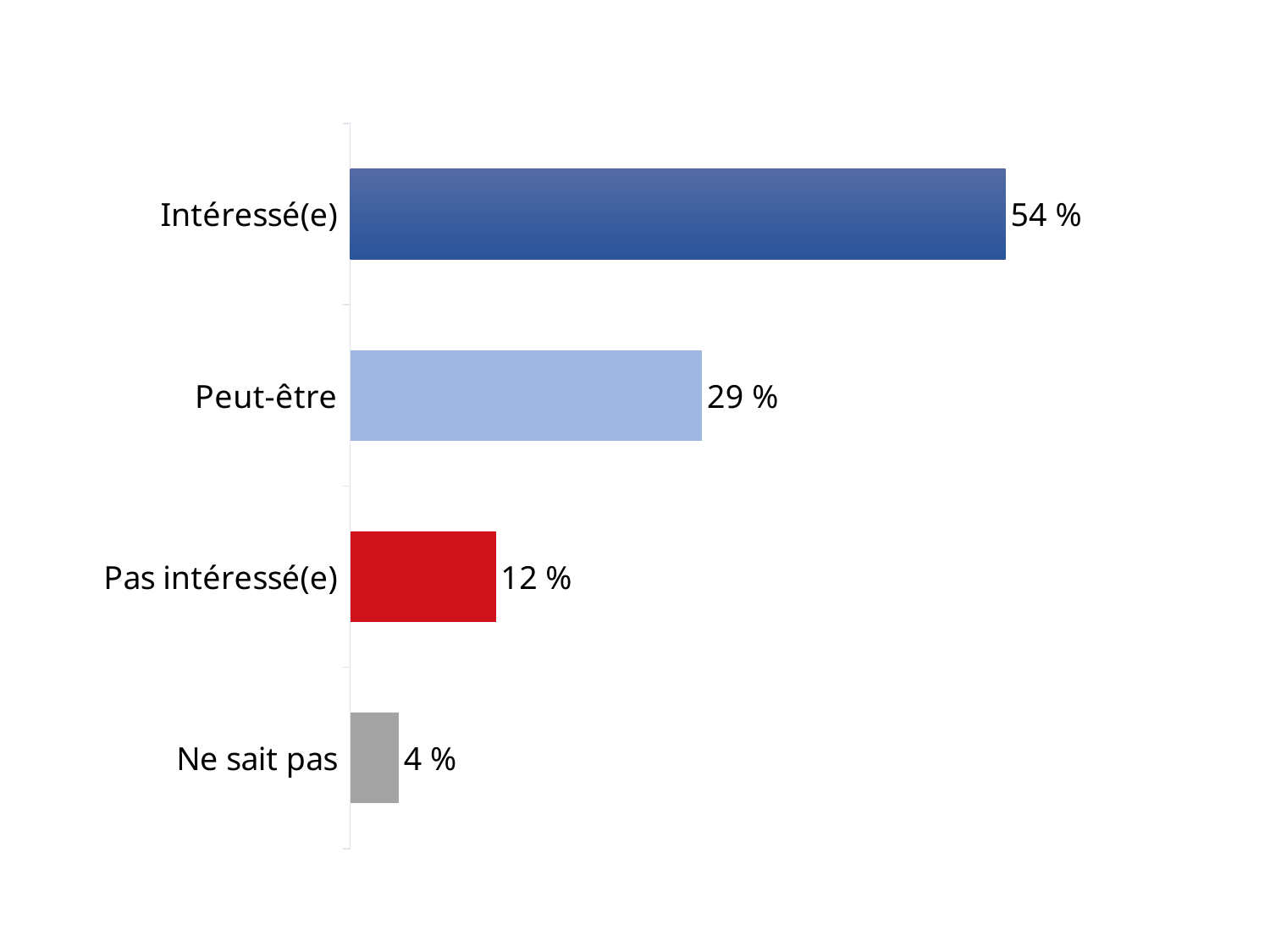
Which is larger, the value for Peut-être or the value for Pas intéressé(e)? Peut-être What colour is the bar for Pas intéressé(e)? Red What is the value for Pas intéressé(e)? 12 % What is the difference between the values for Pas intéressé(e) and Ne sait pas? 8 % What is the value for Peut-être? 29 % What is the value for Intéressé(e)? 54 % What is the difference between the values for Intéressé(e) and Peut-être? 25 % Which category has the lowest value? Ne sait pas How many categories are shown in the chart? 4 Which category has the highest value? Intéressé(e) What kind of chart is this? Bar chart What is the value for Ne sait pas? 4 %